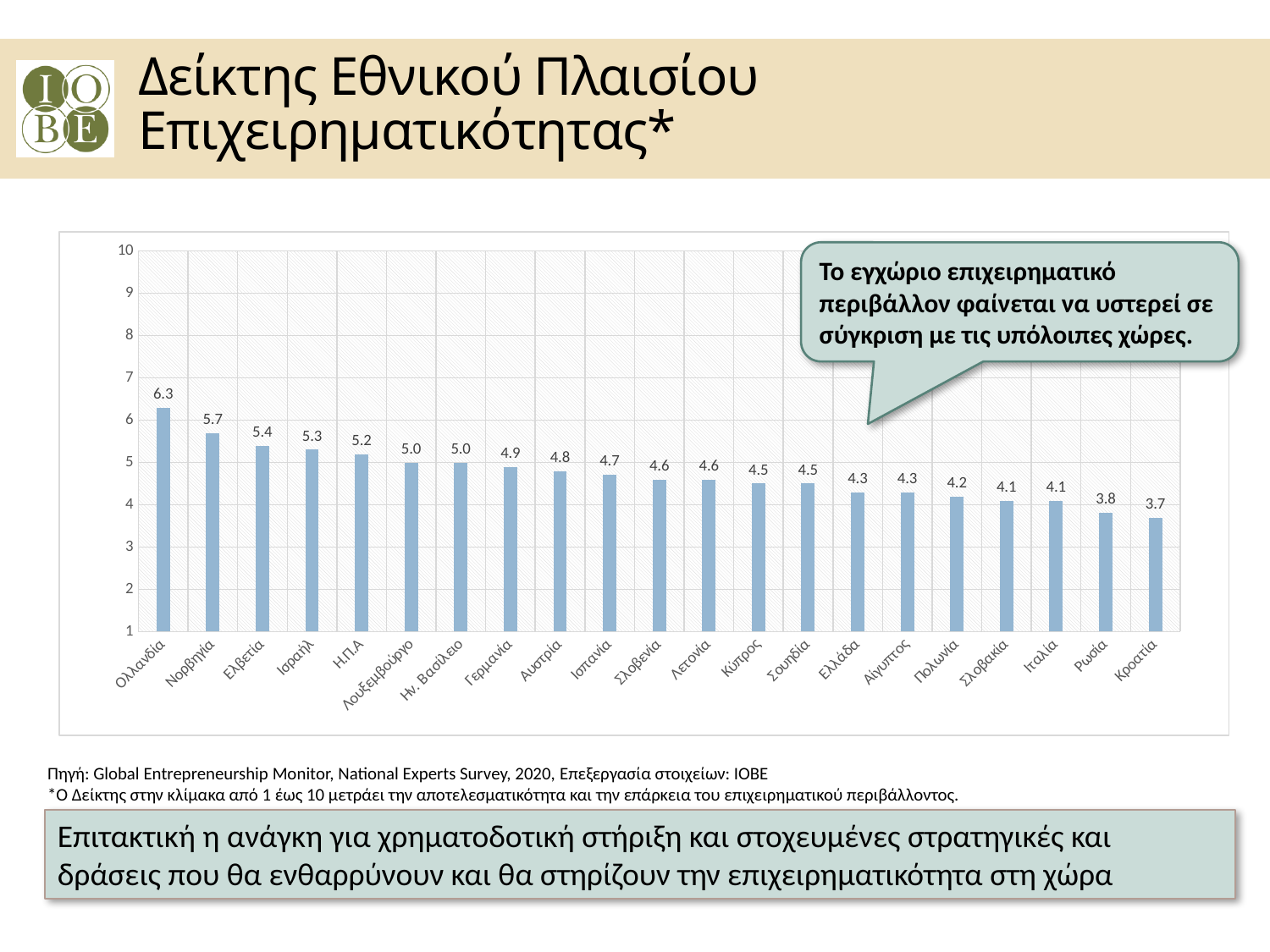
Which country has the lowest value? Κροατία How many countries are shown in the chart? 21 Do the values rise or fall from left to right along the x axis? Fall Which has a larger value, Ρωσία or Πολωνία? Πολωνία Which country has the highest value? Ολλανδία Which has a larger value, Ισραήλ or Ιταλία? Ισραήλ What is the value for Ελλάδα (Greece)? 4.3 What is the difference between the values for Νορβηγία and Κροατία? 2.0 What is the value for Ολλανδία (Netherlands)? 6.3 What kind of chart is shown on the slide? Bar chart What is the value for Γερμανία (Germany)? 4.9 What is the difference between the values for Ολλανδία and Ελλάδα? 2.0